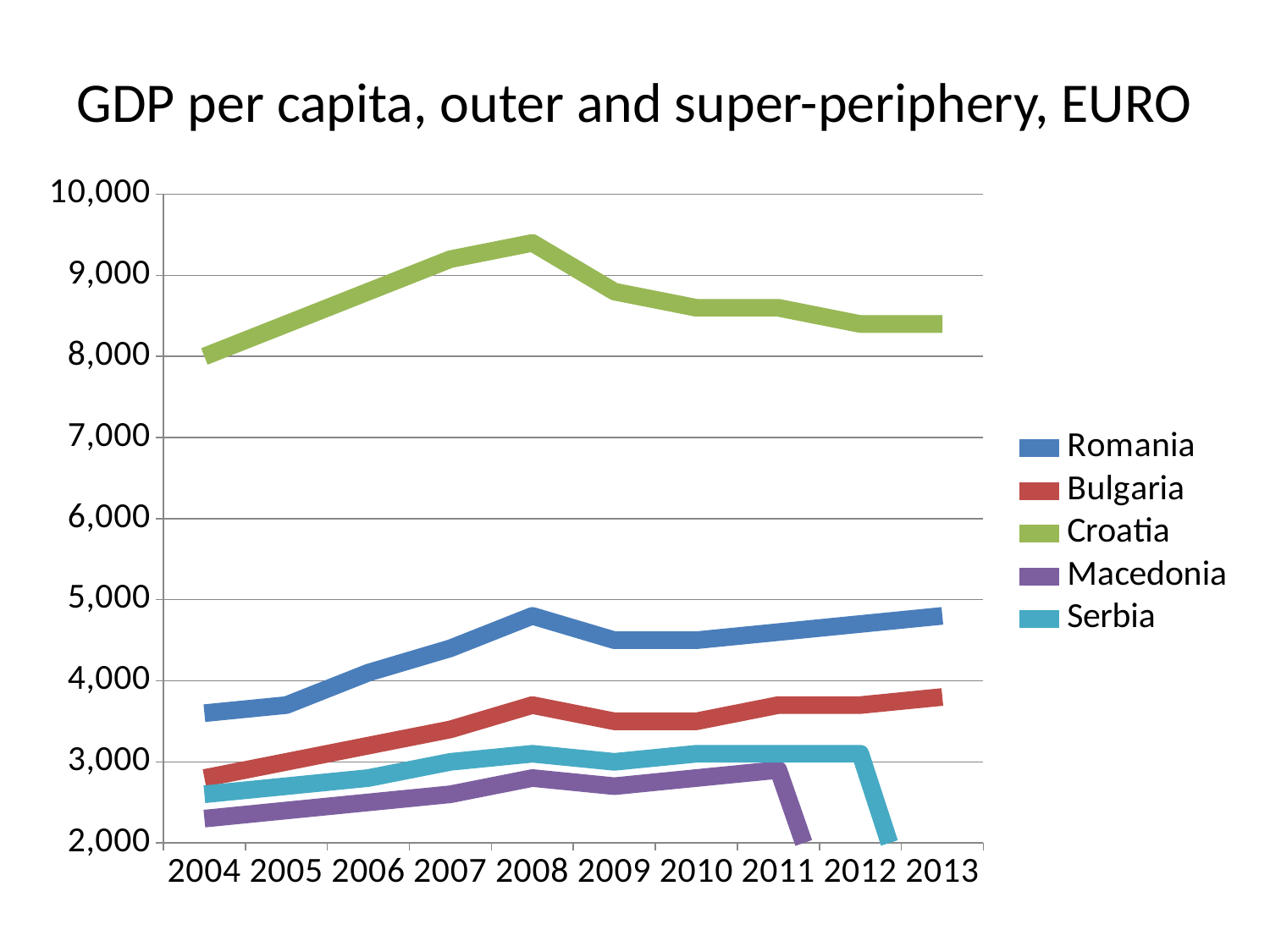
What is the title of the chart? GDP per capita, outer and super-periphery, EURO Is the value for Romania in 2013 greater or less than 4,000? greater What colour is the line for Croatia? green Which country has the lowest GDP per capita in 2004? Macedonia Which is larger in 2010, the value for Romania or the value for Bulgaria? Romania Is the value for Croatia in 2008 greater or less than 9,000? greater Does the value for Croatia rise or fall from 2008 to 2013? fall How many years are shown along the x axis? 10 Which country has the highest GDP per capita in 2008? Croatia What kind of chart is shown on the slide? line chart Is the value for Bulgaria in 2004 greater or less than 3,000? less How many series does the legend list? 5